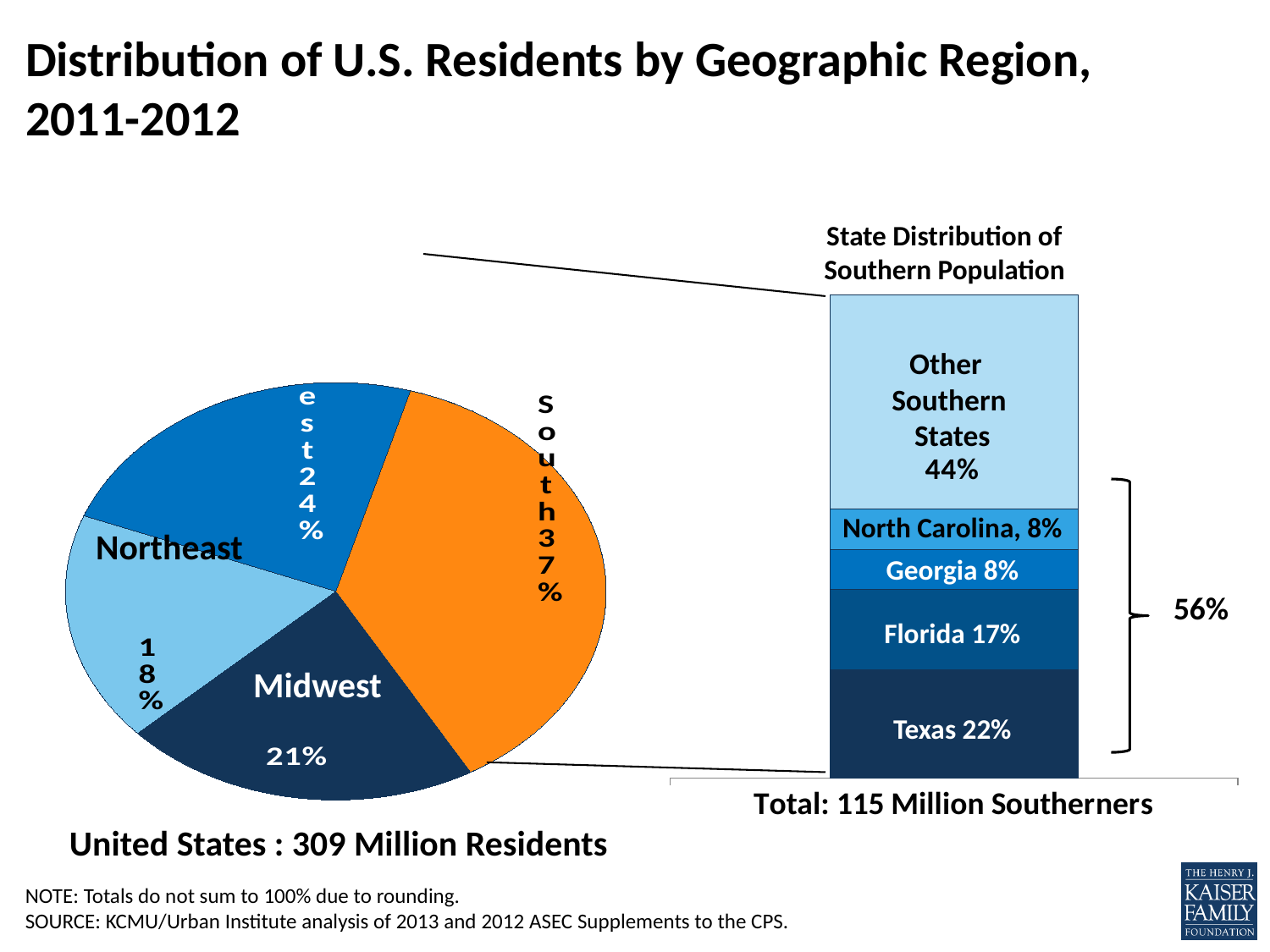
In the pie chart, how many percentage points larger is the South's share than the Northeast's share? 19 In the pie chart, how many regions are shown? 4 What kind of chart is the chart on the left of the slide? Pie chart In the State Distribution of Southern Population bar, how many segments are there? 5 In the State Distribution of Southern Population bar, which is larger, Florida or Georgia? Florida In the State Distribution of Southern Population bar, what share is Texas? 22% In the State Distribution of Southern Population bar, which segment is the largest? Other Southern States In the State Distribution of Southern Population bar, what share is Florida? 17% In the pie chart, what share of U.S. residents live in the South? 37% In the pie chart, which region has the largest share of U.S. residents? South In the pie chart, which region has the smallest share of U.S. residents? Northeast In the pie chart, what share of U.S. residents live in the Midwest? 21%